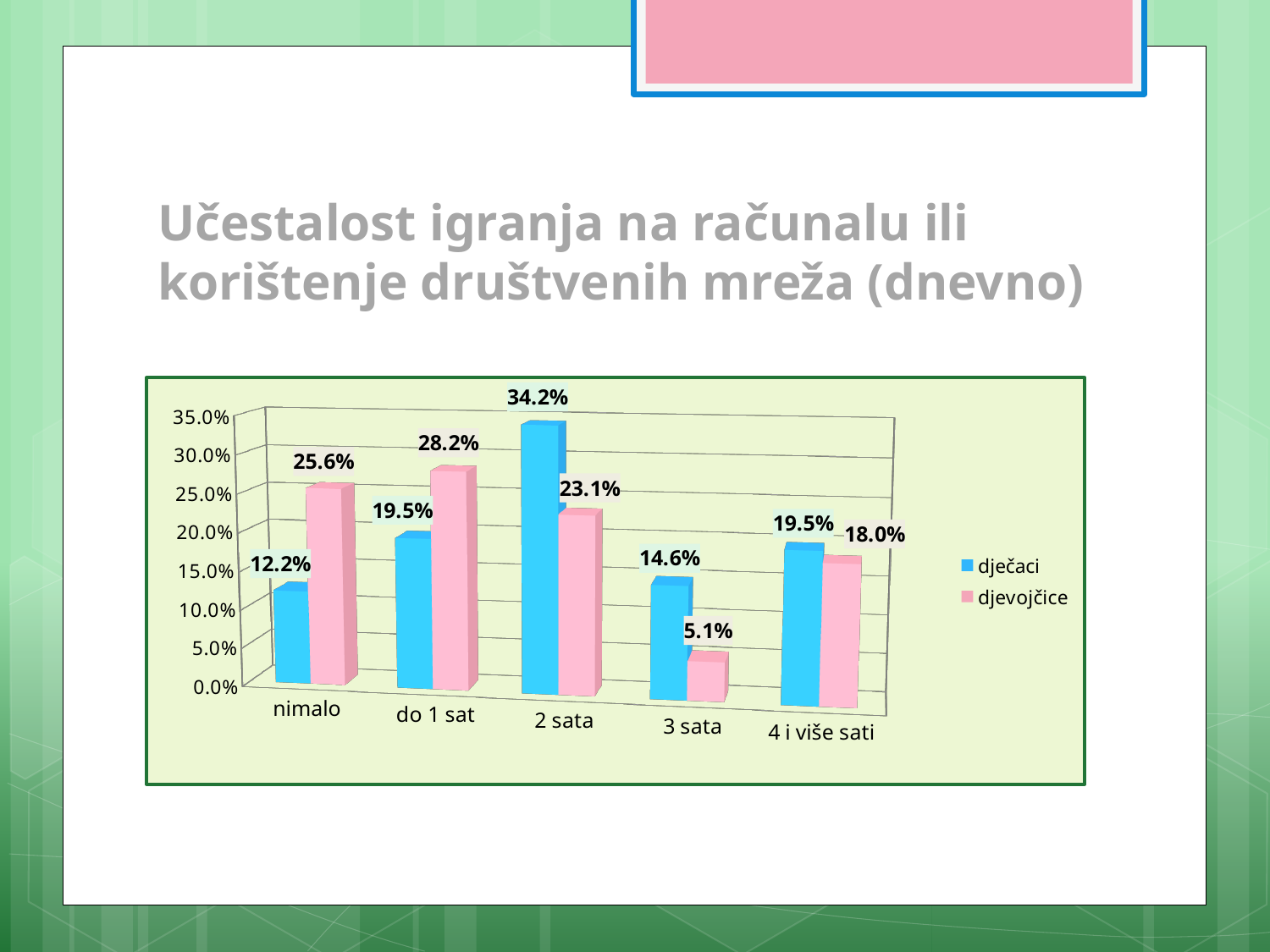
Which category has the lowest value for djevojčice? 3 sata What is the value for djevojčice in the nimalo category? 25.6% Which category has the highest value for dječaci? 2 sata What is the value for dječaci in the 2 sata category? 34.2% How many categories are shown on the x axis? 5 What is the difference between the dječaci and djevojčice values in the 2 sata category? 11.1% How many series does the legend list? 2 Which colour represents the djevojčice series? pink What is the value for djevojčice in the 3 sata category? 5.1% What kind of chart is shown on the slide? bar chart In the nimalo category, which series has the larger value, dječaci or djevojčice? djevojčice What is the value for dječaci in the 4 i više sati category? 19.5%